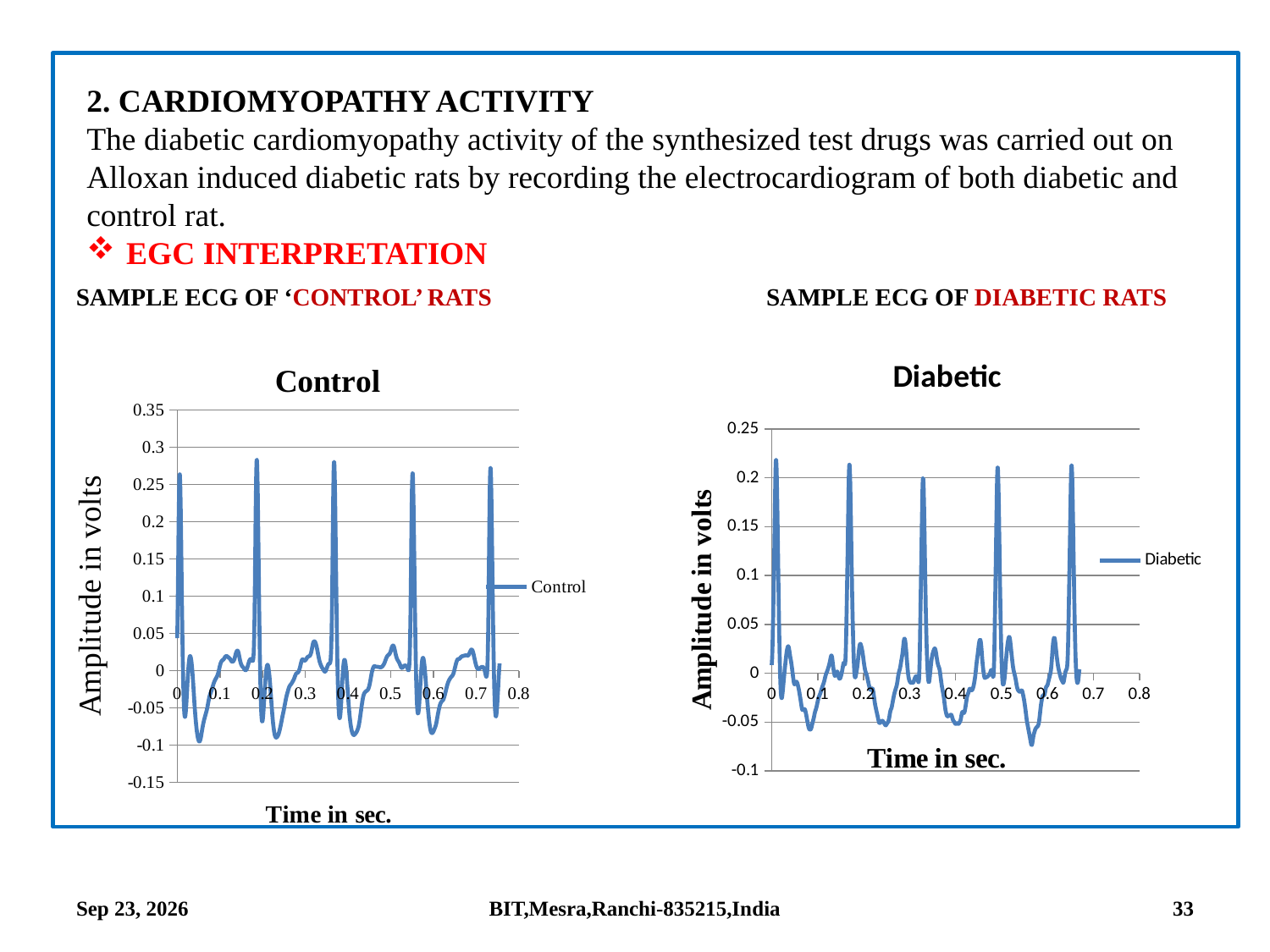
What kind of chart is the 'Diabetic' chart? line chart In the 'Control' chart, is the highest peak of the line greater or less than 0.3? less In the 'Diabetic' chart, what is the legend entry? Diabetic What kind of chart is the 'Control' chart? line chart In the 'Control' chart, how many series does the legend list? 1 In the 'Diabetic' chart, is the highest peak of the line greater or less than 0.15? greater In the 'Control' chart, how many large spikes (peaks above 0.2) does the line show? 5 In the 'Diabetic' chart, is the highest peak of the line greater or less than 0.25? less In the 'Control' chart, what is the y-axis title? Amplitude in volts